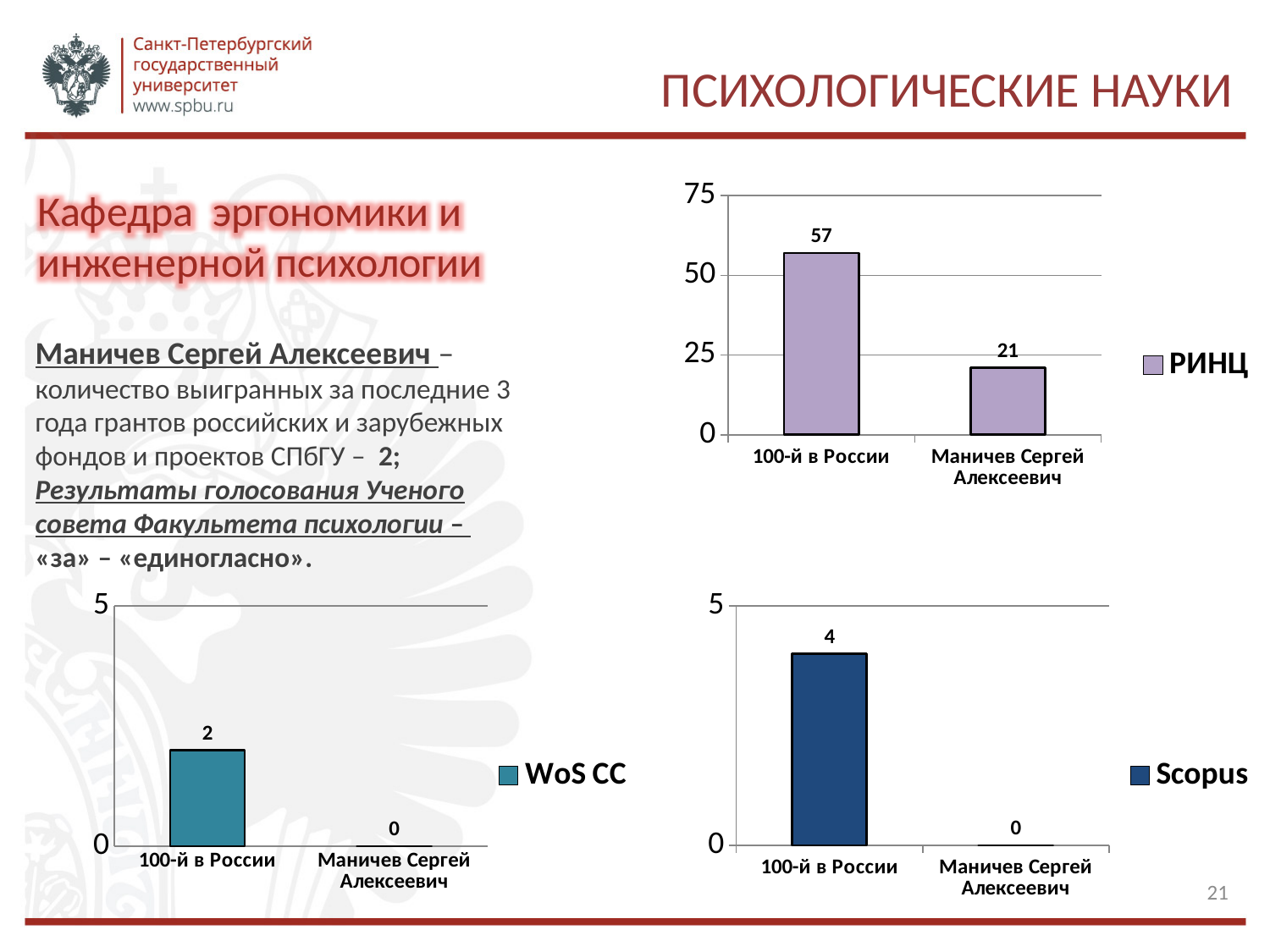
How many categories are shown in the РИНЦ chart (top right)? 2 What type of chart is the Scopus chart (bottom right)? Bar chart What series name does the legend of the bottom-left chart show? WoS CC In the РИНЦ chart (top right), which category has the higher value? 100-й в России In the Scopus chart (bottom right), what is the value for Маничев Сергей Алексеевич? 0 In the Scopus chart (bottom right), which category has the lowest value? Маничев Сергей Алексеевич In the Scopus chart (bottom right), what is the value for 100-й в России? 4 In the WoS CC chart (bottom left), what is the value for 100-й в России? 2 In the РИНЦ chart (top right), what is the difference between the values for 100-й в России and Маничев Сергей Алексеевич? 36 In the РИНЦ chart (top right), what is the value for Маничев Сергей Алексеевич? 21 In the РИНЦ chart (top right), what is the value for 100-й в России? 57 In the WoS CC chart (bottom left), what is the value for Маничев Сергей Алексеевич? 0